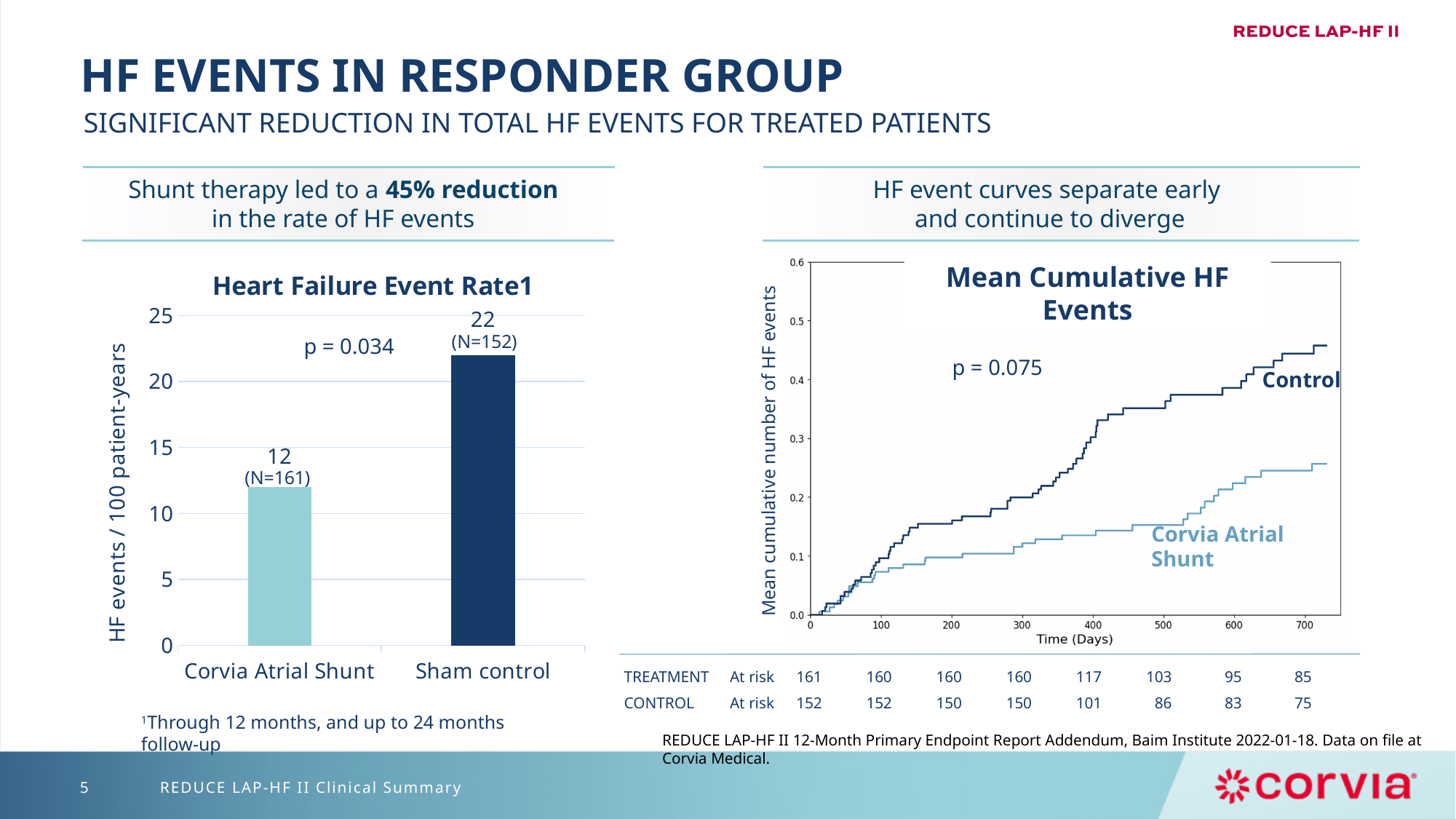
In the Mean Cumulative HF Events chart, is the Corvia Atrial Shunt curve at 700 days greater or less than 0.3? less In the Mean Cumulative HF Events chart, which curve is higher at 700 days, Control or Corvia Atrial Shunt? Control In the Mean Cumulative HF Events chart, is the Control curve at 700 days greater or less than 0.4? greater In the Heart Failure Event Rate chart, what is the difference between the Sham control and Corvia Atrial Shunt values? 10 In the Heart Failure Event Rate chart, which category has the higher HF event rate? Sham control In the Heart Failure Event Rate chart, which category has the lower HF event rate? Corvia Atrial Shunt In the Heart Failure Event Rate chart, what p-value is shown? p = 0.034 In the Mean Cumulative HF Events chart, do the curves rise or fall as time increases? Rise What kind of chart is the Heart Failure Event Rate chart? Bar chart In the Heart Failure Event Rate chart, what is the value for Corvia Atrial Shunt? 12 In the Heart Failure Event Rate chart, what is the value for Sham control? 22 In the Heart Failure Event Rate chart, how many categories are shown? 2